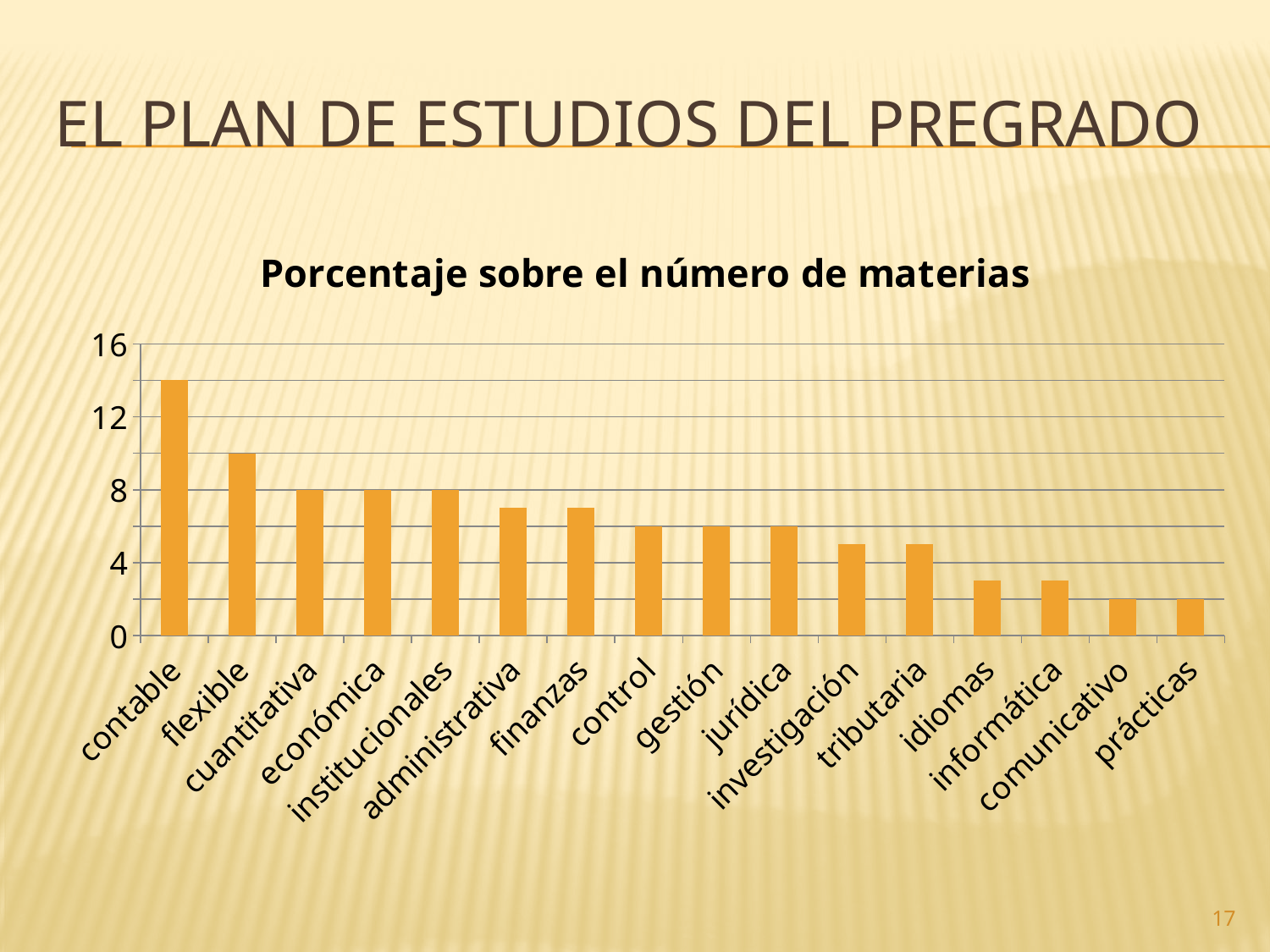
Is the value for idiomas greater or less than 4? less What is the highest value shown on the vertical axis? 16 Which is larger, the value for flexible or the value for tributaria? flexible Is the value for investigación greater or less than 4? greater What is the title of the chart? Porcentaje sobre el número de materias What is the value for cuantitativa? 8 Do the values generally rise or fall from left to right along the x axis? fall What kind of chart is shown on the slide? bar chart What is the value for institucionales? 8 Which category has the highest value in the chart? contable How many categories are shown on the x axis of the chart? 16 Is the value for contable greater or less than 12? greater